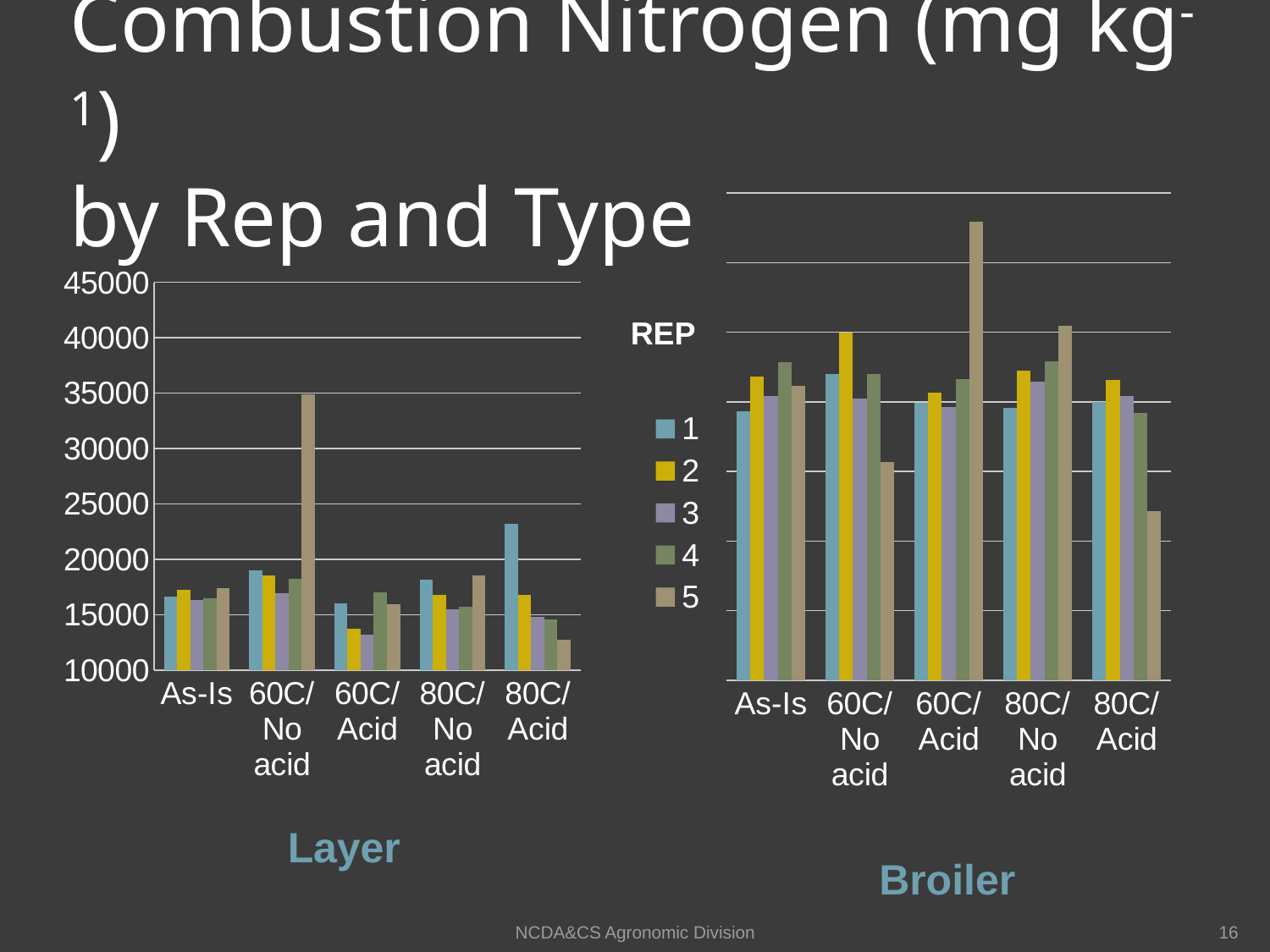
What is the title of the legend shared by the two charts? REP How many series does the REP legend list? 5 How many categories are shown on the x axis of the Broiler chart? 5 In the Broiler chart, which rep has the tallest bar in the 60C/Acid category? 5 In the Layer chart, which rep has the highest bar in the 60C/No acid category? 5 What kind of chart is the Layer chart on the left of the slide? bar chart In the Layer chart, is the value for rep 1 at 80C/Acid greater or less than 20000? greater In the Broiler chart, which rep has the lowest bar in the 80C/Acid category? 5 In the Layer chart, is the value for rep 5 at 80C/Acid greater or less than 15000? less In the Broiler chart, which is larger: rep 5 at 60C/Acid or rep 2 at 60C/No acid? rep 5 at 60C/Acid In the Layer chart, which rep has the lowest bar in the 80C/Acid category? 5 In the Layer chart, is the value for rep 5 at 60C/No acid greater or less than 30000? greater